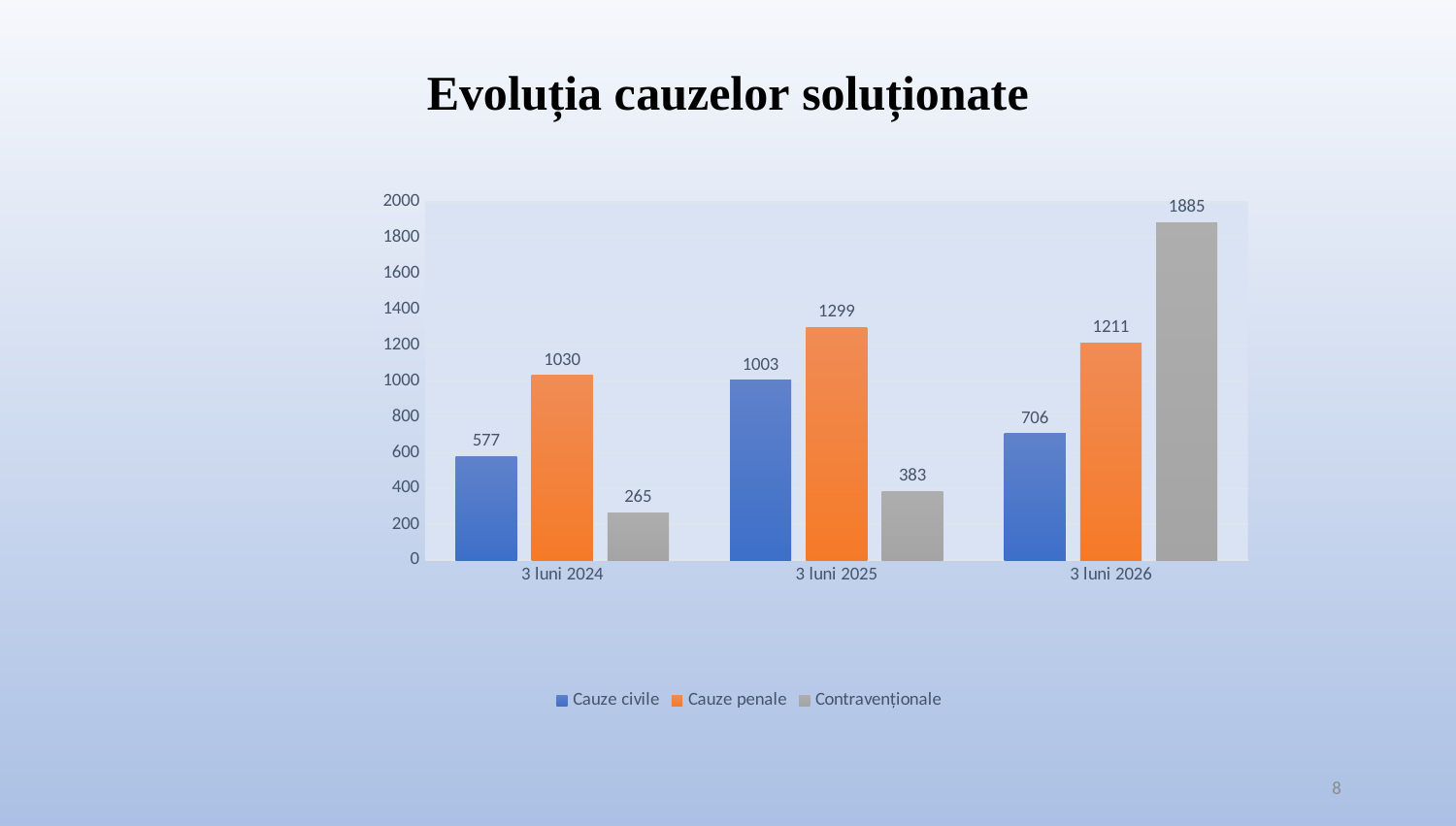
How many periods are shown on the x axis? 3 Which is larger in 3 luni 2026: Cauze penale or Contravenționale? Contravenționale What kind of chart is shown on the slide? bar chart What is the value for Contravenționale in 3 luni 2026? 1885 Which period has the lowest value for Contravenționale? 3 luni 2024 Is the value for Cauze civile in 3 luni 2026 greater or less than 800? less What is the title of the chart? Evoluția cauzelor soluționate How many series does the legend list? 3 What is the difference between Cauze penale in 3 luni 2025 and in 3 luni 2024? 269 Which period has the highest value for Cauze civile? 3 luni 2025 What is the value for Cauze penale in 3 luni 2025? 1299 What is the value for Cauze civile in 3 luni 2024? 577